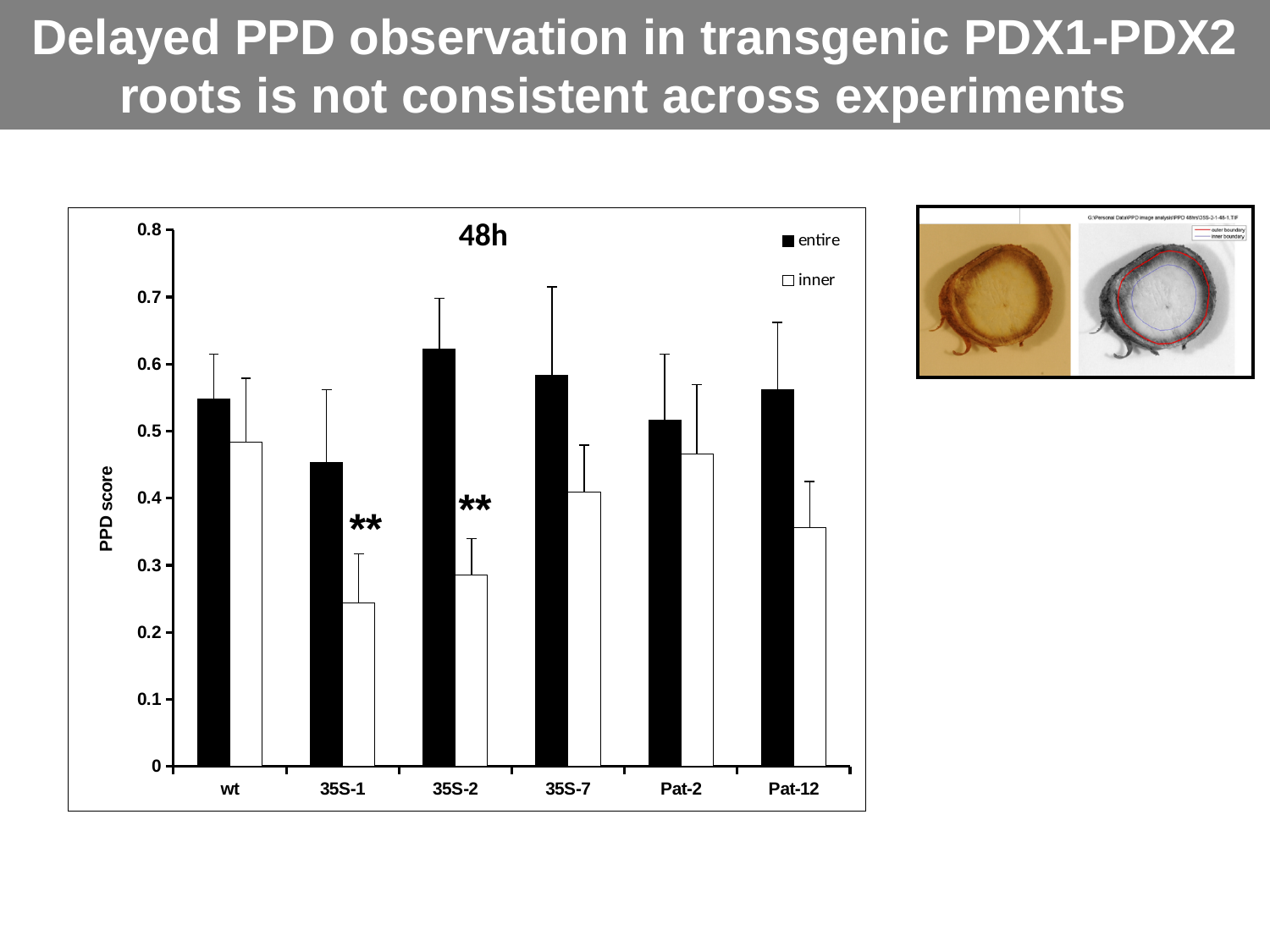
What is the title shown inside the chart? 48h Is the 'entire' value for 35S-1 greater or less than 0.5? less Which category has the lowest value for the 'inner' series? 35S-1 What kind of chart is shown on the slide? bar chart Is the 'entire' value for 35S-2 greater or less than 0.6? greater For 35S-2, which is larger, the 'entire' value or the 'inner' value? entire Which category has the lowest value for the 'entire' series? 35S-1 How many categories are shown on the x axis of the chart? 6 How many series does the chart's legend list? 2 What is the label of the y axis? PPD score Which category has the highest value for the 'entire' series? 35S-2 Is the 'inner' value for 35S-1 greater or less than 0.3? less